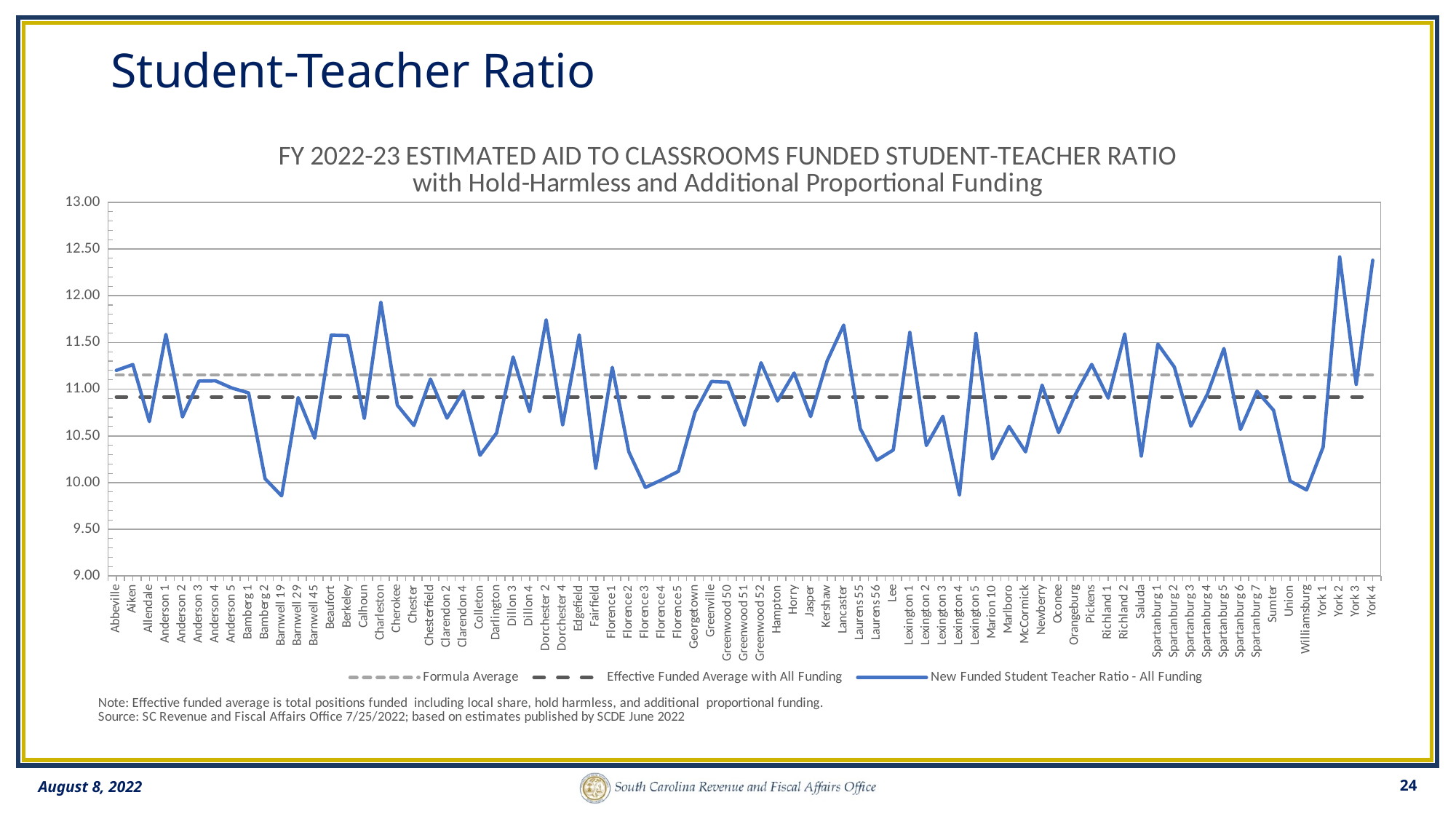
How many series does the legend list? 3 Which legend entry is drawn as a solid blue line? New Funded Student Teacher Ratio - All Funding What kind of chart is shown on the slide? line chart Is the New Funded Student Teacher Ratio for Florence 3 greater or less than 10.50? less Is the New Funded Student Teacher Ratio for Dorchester 2 greater or less than 11.50? greater Is the New Funded Student Teacher Ratio for Marion 10 greater or less than 10.50? less Which has the higher New Funded Student Teacher Ratio, Charleston or Berkeley? Charleston What is the first line of the chart title? FY 2022-23 ESTIMATED AID TO CLASSROOMS FUNDED STUDENT-TEACHER RATIO Which has the higher New Funded Student Teacher Ratio, Aiken or Barnwell 19? Aiken